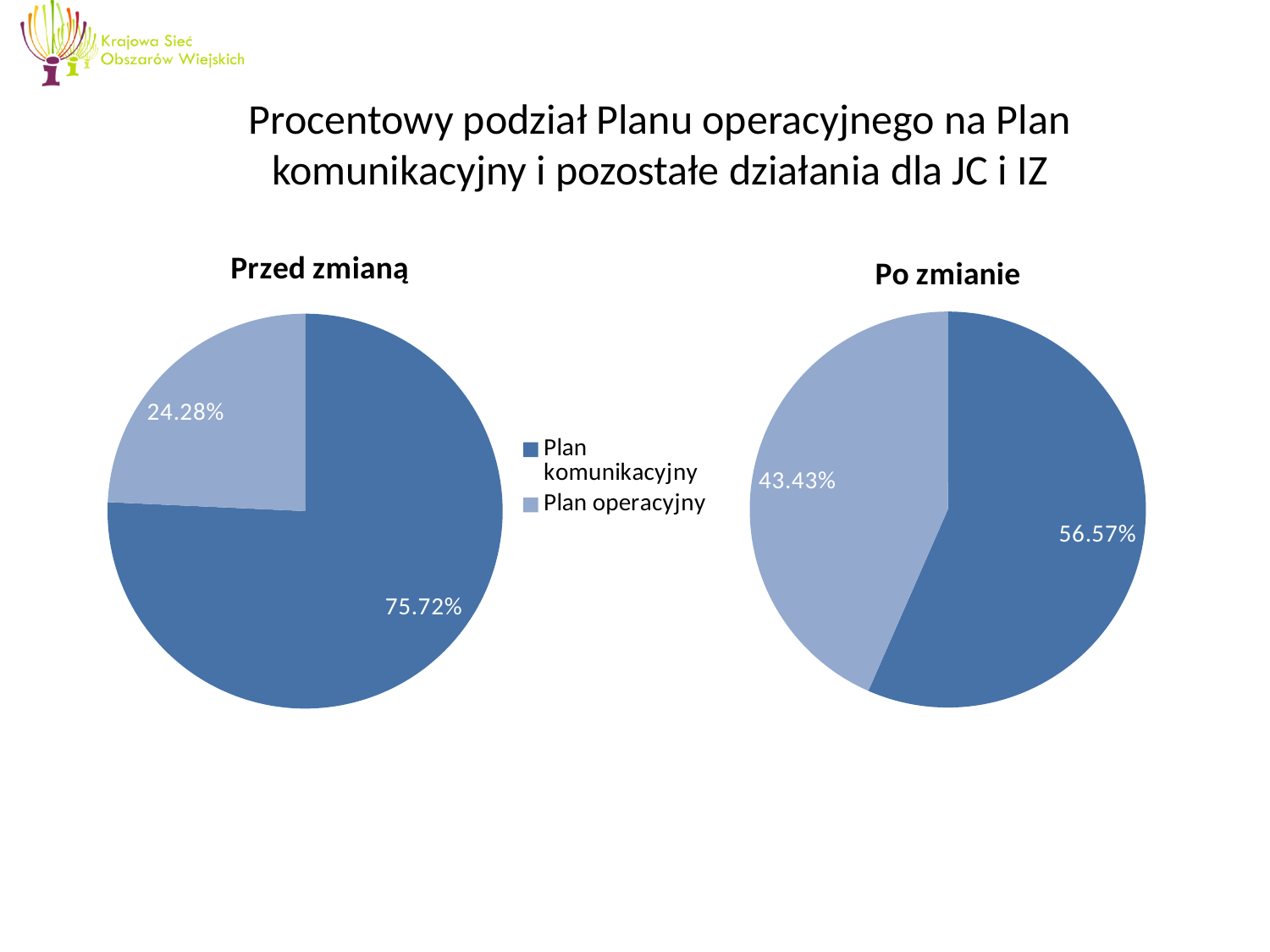
In the 'Po zmianie' chart, what is the difference between the Plan komunikacyjny and Plan operacyjny shares? 13.14% In the 'Po zmianie' chart, what share does Plan operacyjny have? 43.43% In the 'Przed zmianą' chart, which slice is the largest? Plan komunikacyjny In the 'Przed zmianą' chart, what share does Plan komunikacyjny have? 75.72% What type of chart is used for 'Przed zmianą' and 'Po zmianie'? Pie chart In the 'Po zmianie' chart, what share does Plan komunikacyjny have? 56.57% In the 'Przed zmianą' chart, what is the difference between the Plan komunikacyjny and Plan operacyjny shares? 51.44% How many slices does the 'Po zmianie' chart have? 2 In the 'Po zmianie' chart, which slice is the smallest? Plan operacyjny How many entries does the legend list? 2 Is the Plan operacyjny share larger in the 'Przed zmianą' chart or in the 'Po zmianie' chart? Po zmianie In the 'Przed zmianą' chart, what share does Plan operacyjny have? 24.28%